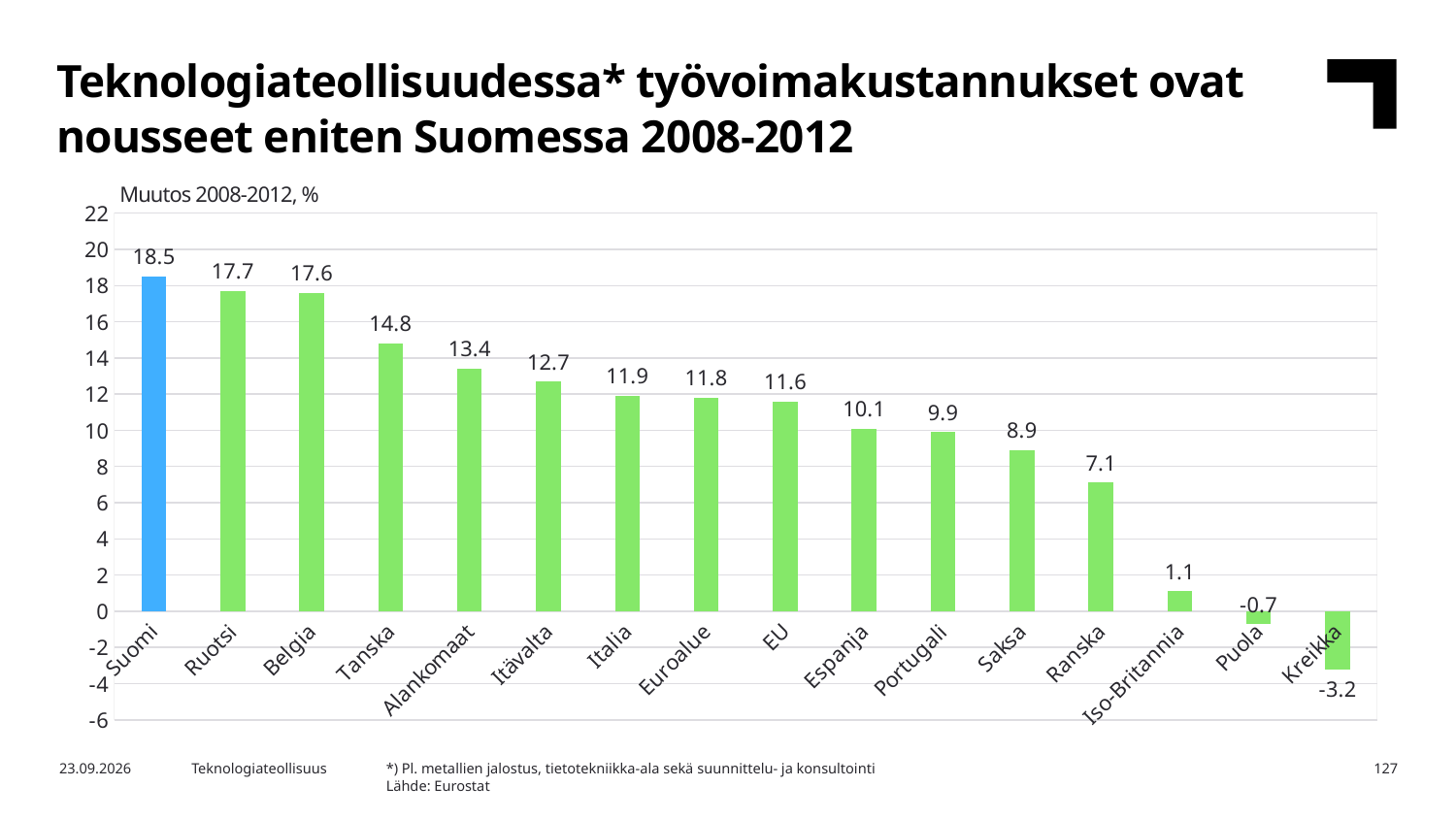
What is the value for Kreikka? -3.2 Which is larger, the value for Tanska or the value for Itävalta? Tanska Do the values rise or fall from left to right along the x axis? fall What is the value for Alankomaat? 13.4 Which country has the lowest value? Kreikka What is the value for Suomi? 18.5 Which bar is coloured differently from the others? Suomi How many countries or regions are shown on the x axis? 16 Which country has the highest value? Suomi What kind of chart is this? bar chart What is the difference between the values for Suomi and Ruotsi? 0.8 What is the value for EU? 11.6